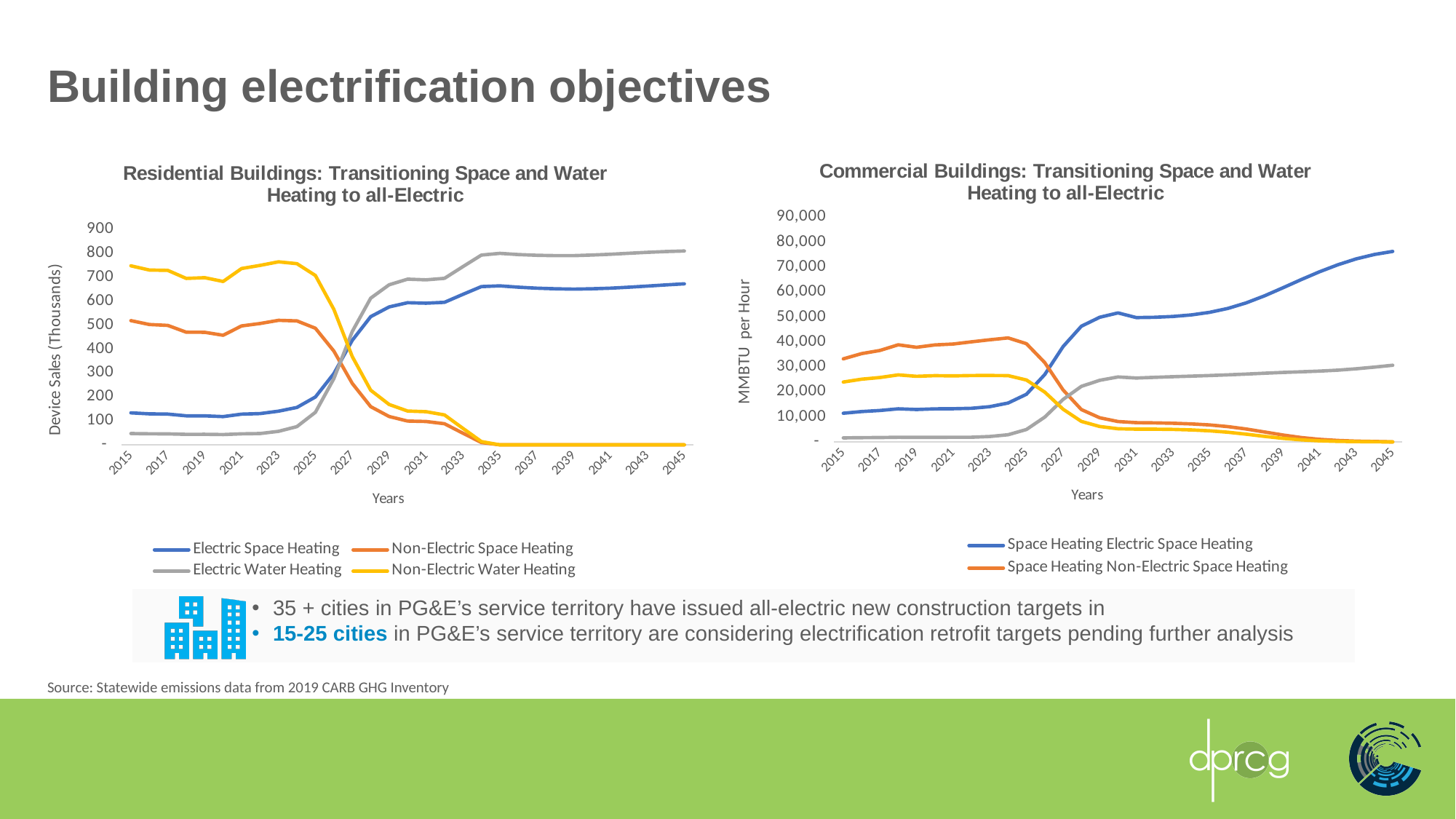
What kind of chart is the Residential Buildings chart on the left? Line chart In the Residential Buildings chart, is the value for Electric Space Heating in 2045 greater or less than 600? greater In the Residential Buildings chart, which is higher in 2045: Electric Water Heating or Electric Space Heating? Electric Water Heating In the Commercial Buildings chart, does the Space Heating Electric Space Heating line rise or fall from 2015 to 2045? Rises In the Residential Buildings chart, is the value for Electric Water Heating in 2015 greater or less than 100? less How many series does the legend of the Residential Buildings chart list? 4 In the Residential Buildings chart, does the Non-Electric Space Heating line rise or fall from 2015 to 2045? Falls In the Commercial Buildings chart, is the value for Space Heating Electric Space Heating in 2045 greater or less than 70,000? greater In the Commercial Buildings chart, which is higher in 2015: Space Heating Electric Space Heating or Space Heating Non-Electric Space Heating? Space Heating Non-Electric Space Heating What is the y-axis label of the Residential Buildings chart? Device Sales (Thousands) How many series does the legend of the Commercial Buildings chart list? 2 In the Residential Buildings chart, does the Electric Space Heating line rise or fall from 2015 to 2045? Rises